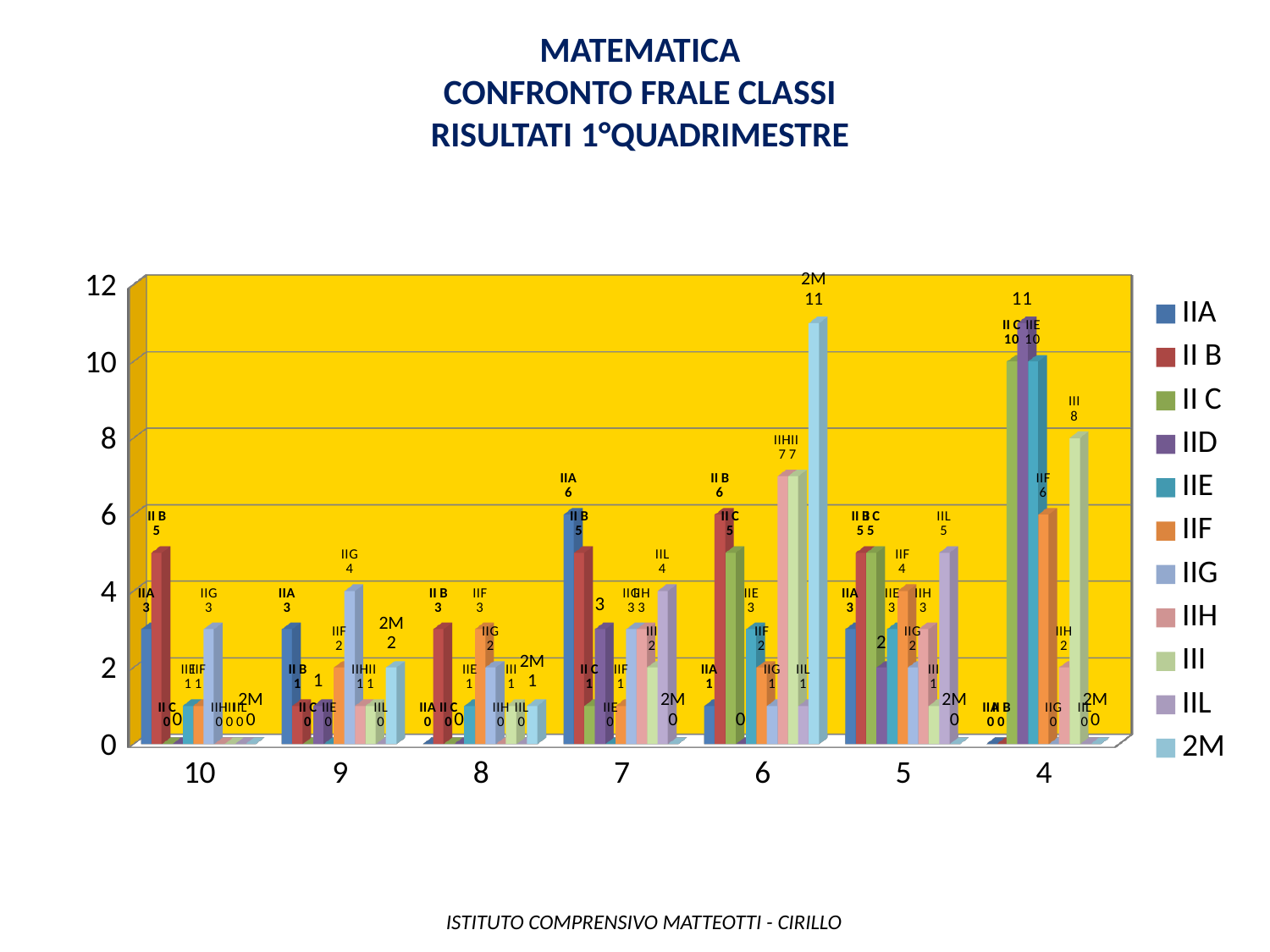
What is the value for series III in category 4? 8 What is the value for series 2M in category 6? 11 What is the value for series IIL in category 5? 5 Is the value for IID in category 4 greater or less than 10? greater How many categories are shown on the x axis? 7 What kind of chart is shown on the slide? bar chart Which is larger: the value for IIA in category 7 or the value for IIG in category 9? IIA in category 7 What is the value for series IIF in category 4? 6 What is the difference between the value for 2M in category 6 and the value for IIF in category 4? 5 What is the value for series IIG in category 9? 4 How many series does the legend list? 11 In which category does series 2M reach its highest value? 6